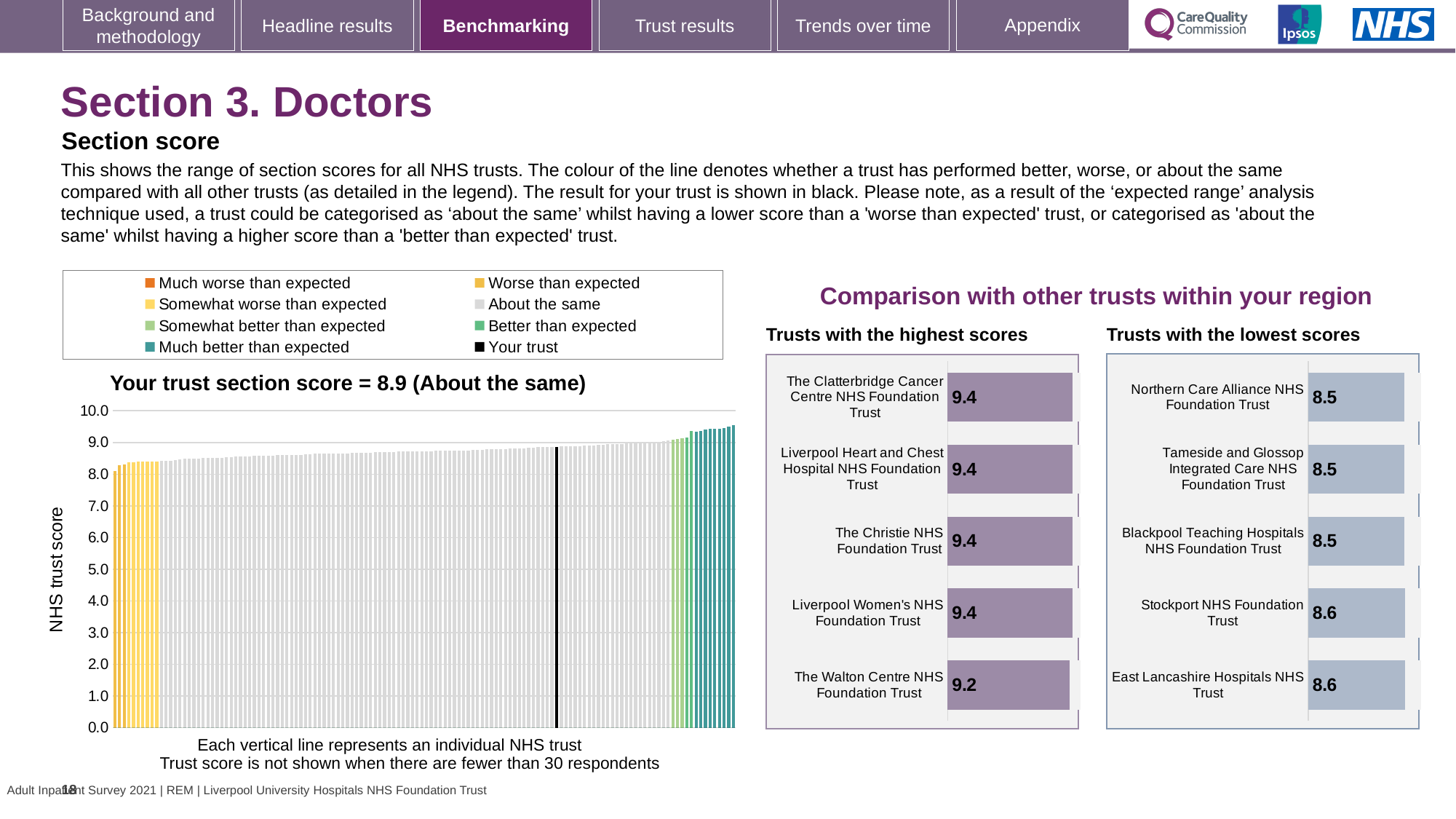
How many trusts are shown in the 'Trusts with the lowest scores' chart? 5 How many entries does the legend above the 'Your trust section score' chart list? 8 In the 'Trusts with the highest scores' chart, which trust has the lowest score? The Walton Centre NHS Foundation Trust In the 'Your trust section score' chart, what is the section score for your trust? 8.9 In the 'Trusts with the highest scores' chart, what is the score for The Walton Centre NHS Foundation Trust? 9.2 In the 'Trusts with the lowest scores' chart, which has the larger score: Stockport NHS Foundation Trust or Blackpool Teaching Hospitals NHS Foundation Trust? Stockport NHS Foundation Trust In the 'Trusts with the lowest scores' chart, what is the score for Stockport NHS Foundation Trust? 8.6 In the 'Your trust section score' chart, which category is your trust placed in? About the same In the 'Your trust section score' chart, is the value of the lowest-scoring trust greater or less than 9.0? less In the 'Trusts with the highest scores' chart, what is the difference between the scores of The Clatterbridge Cancer Centre NHS Foundation Trust and The Walton Centre NHS Foundation Trust? 0.2 What kind of chart is the 'Your trust section score' chart? bar chart In the 'Your trust section score' chart, what is the label on the vertical axis? NHS trust score